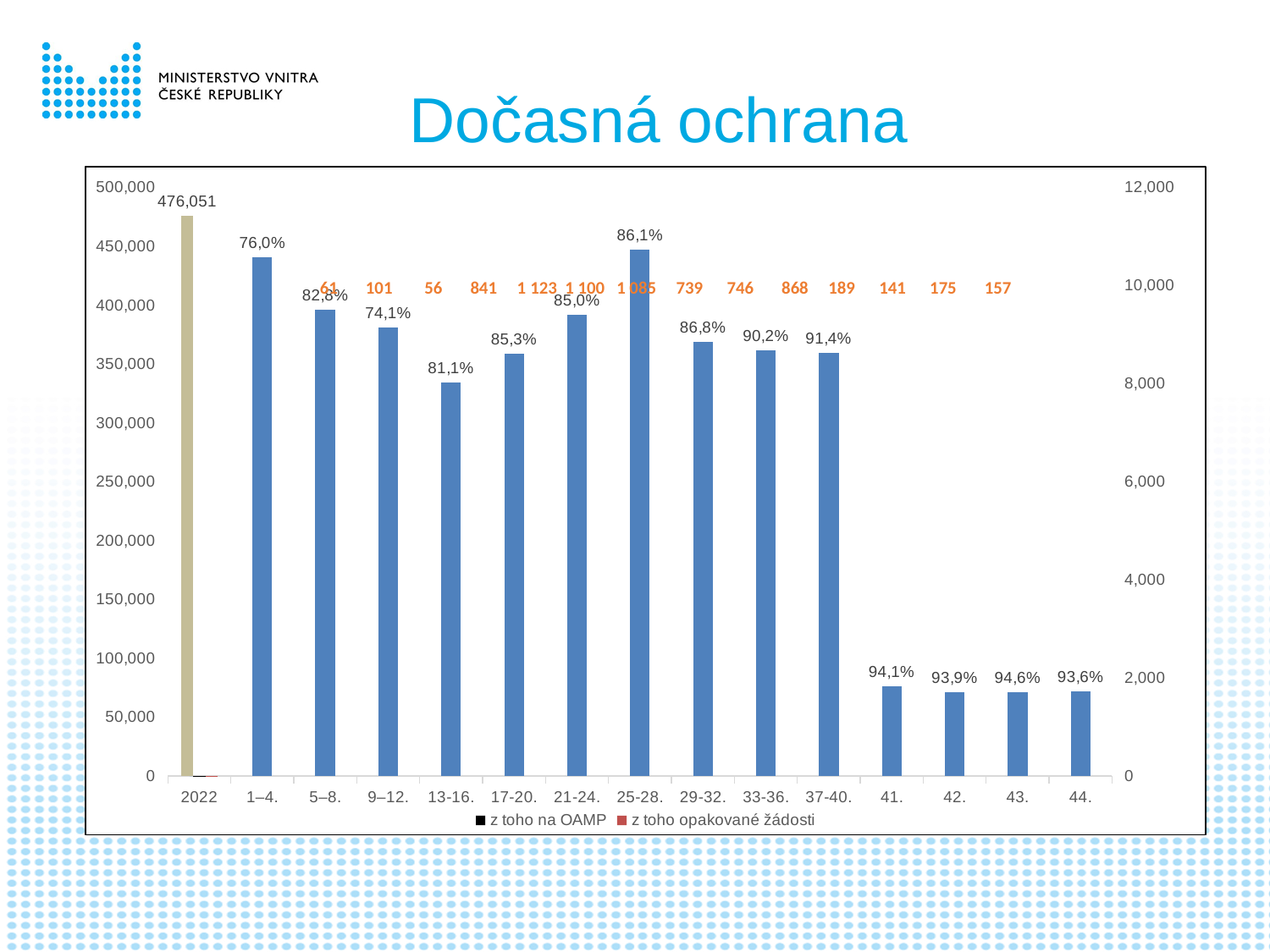
What percentage is labelled above the bar for 44.? 93,6% Which of the blue bars is the tallest? 25-28. On the right-hand axis, is the value of the blue bar for 25-28. greater or less than 10,000? greater What value is labelled on the bar for 2022? 476,051 What percentage is labelled above the bar for 25-28.? 86,1% How many series does the legend list? 2 What is the difference between the percentage labels for 43. and 9–12.? 20,5% Which category has the lowest percentage label? 9–12. What kind of chart is shown on the slide? bar chart What is the title of the chart? Dočasná ochrana Which category has the highest percentage label? 43. How many categories are shown on the x axis? 15